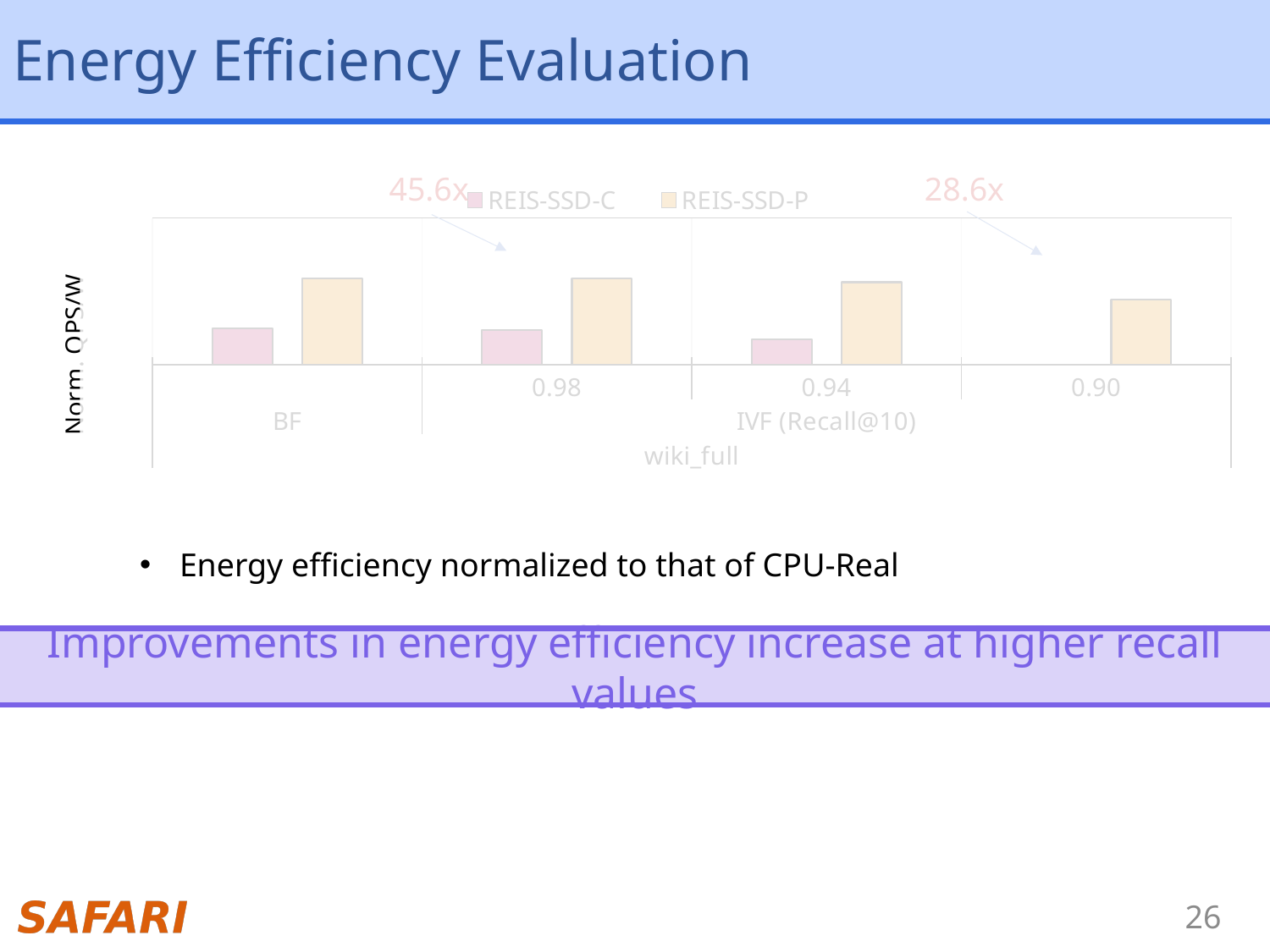
What improvement factor is annotated with an arrow pointing to the 0.90 recall group? 28.6x How many category groups are shown along the x axis? 4 Is the REIS-SSD-C value for IVF recall 0.98 larger or smaller than the REIS-SSD-C value for IVF recall 0.94? larger For the BF category, which series has the larger value, REIS-SSD-C or REIS-SSD-P? REIS-SSD-P For the IVF recall value 0.94, which series has the larger value, REIS-SSD-C or REIS-SSD-P? REIS-SSD-P How many series does the legend list? 2 What are the two series named in the legend? REIS-SSD-C and REIS-SSD-P Across the IVF recall values 0.98, 0.94 and 0.90, do the REIS-SSD-P values rise or fall? fall Among the categories where a REIS-SSD-C bar is shown, which has the lowest REIS-SSD-C value? 0.94 Which category has the lowest REIS-SSD-P value? 0.90 What kind of chart is shown on the slide? bar chart